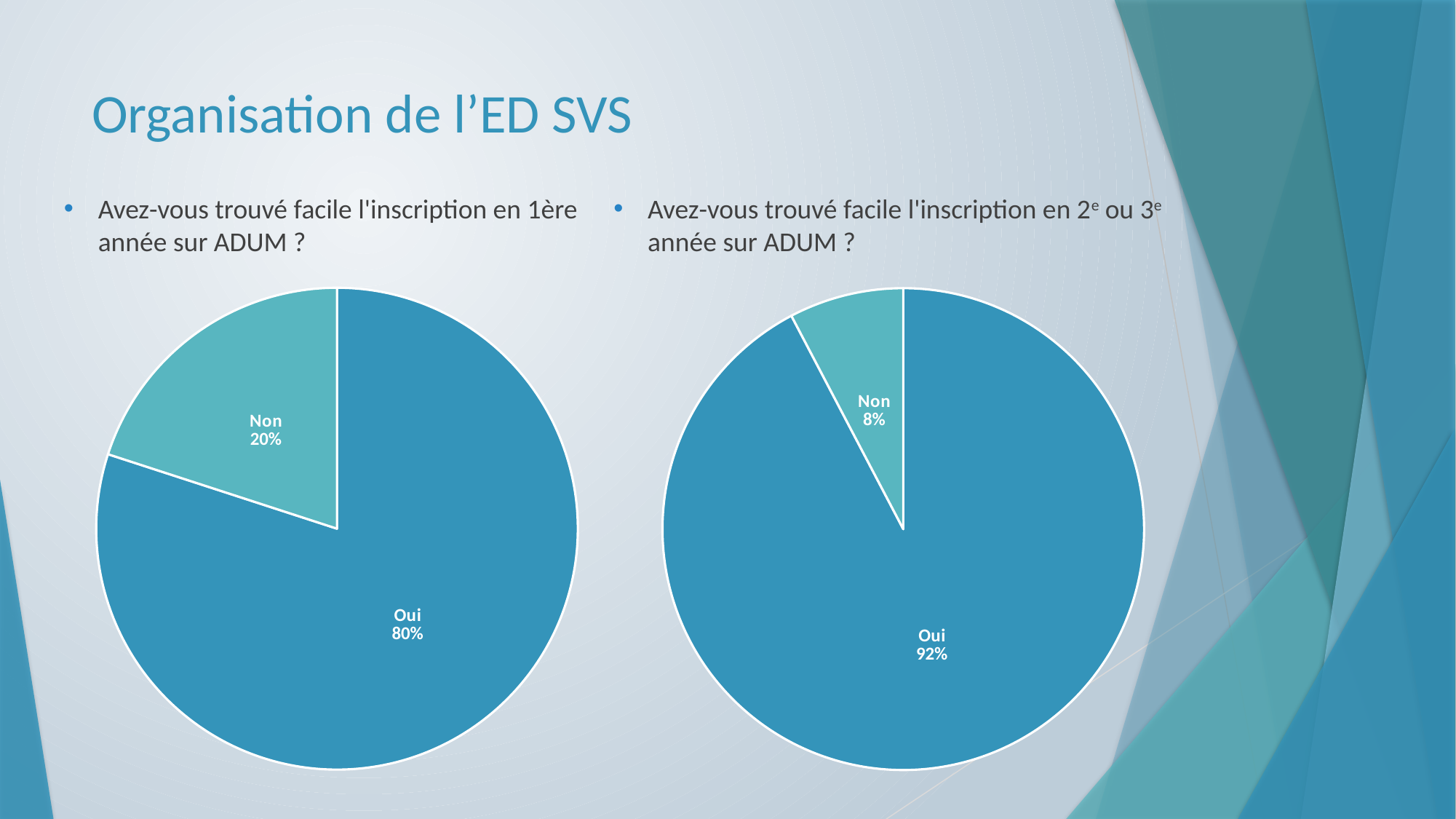
How many charts are shown on the slide? 2 In the left pie chart (1ère année sur ADUM), what is the difference in percentage points between 'Oui' and 'Non'? 60 How many slices does the left pie chart (1ère année sur ADUM) have? 2 In the left pie chart (1ère année sur ADUM), which category has the largest slice? Oui In the left pie chart (1ère année sur ADUM), what share of responses is 'Oui'? 80% In the right pie chart (2e ou 3e année sur ADUM), what is the difference in percentage points between 'Oui' and 'Non'? 84 Which chart has the larger 'Non' share, the left pie chart (1ère année) or the right pie chart (2e ou 3e année)? The left pie chart (1ère année) In the left pie chart (1ère année sur ADUM), what share of responses is 'Non'? 20% In the right pie chart (2e ou 3e année sur ADUM), what share of responses is 'Oui'? 92% In the right pie chart (2e ou 3e année sur ADUM), what share of responses is 'Non'? 8% What type of chart is used on the right side of the slide (2e ou 3e année sur ADUM)? Pie chart In the right pie chart (2e ou 3e année sur ADUM), which category has the smallest slice? Non